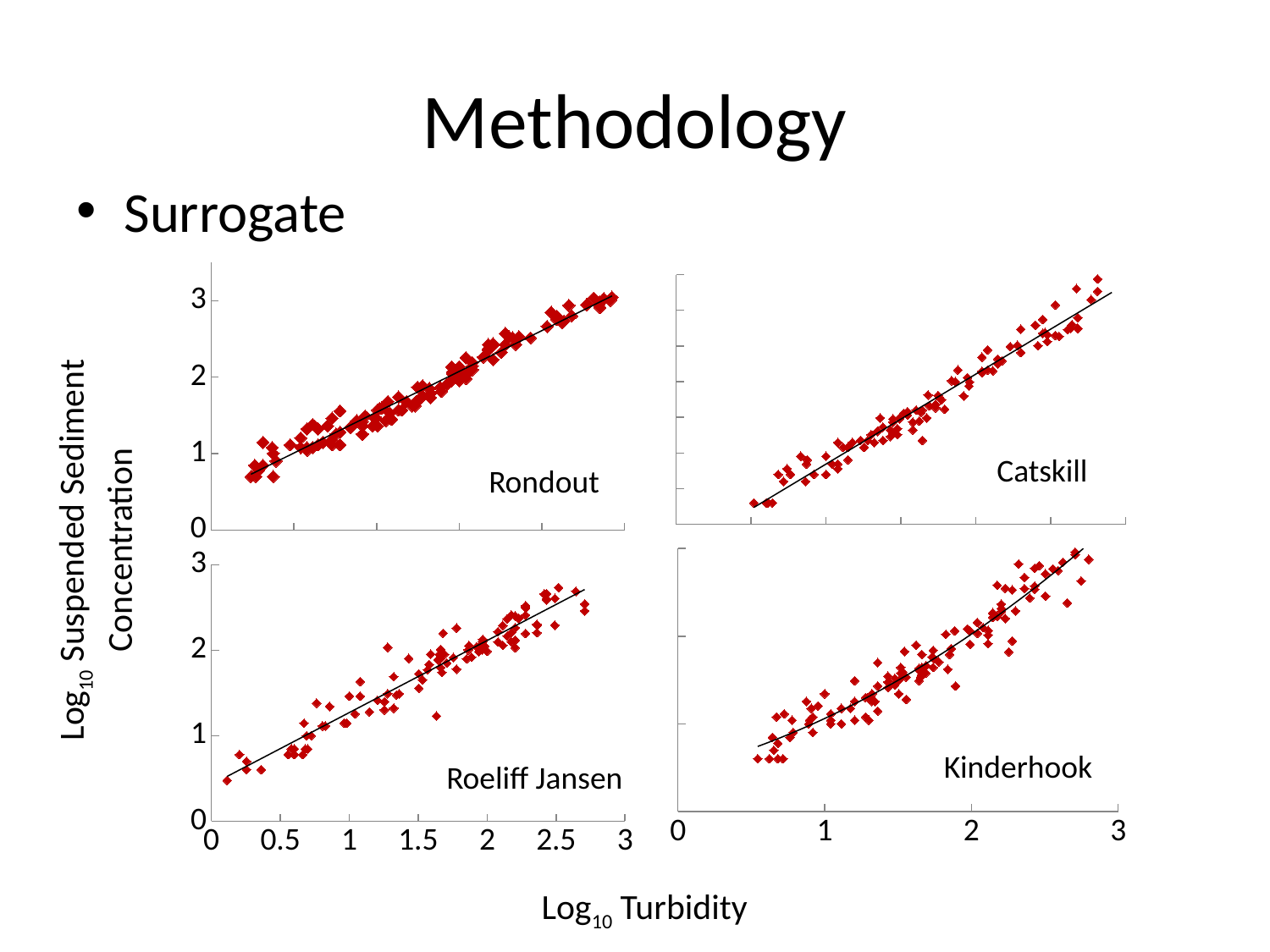
Which chart is in the bottom-right position on the slide? Kinderhook What is the label of the shared y axis for the four charts? Log10 Suspended Sediment Concentration What kind of chart is the Rondout chart? scatter plot Which chart reaches a higher maximum Log10 Suspended Sediment Concentration, Rondout or Roeliff Jansen? Rondout What is the label of the shared x axis for the four charts? Log10 Turbidity In the Rondout chart, is the highest plotted Log10 Suspended Sediment Concentration greater or less than 2? greater In the Rondout chart, do the values rise or fall as Log10 Turbidity increases? rise In the Roeliff Jansen chart, is the lowest plotted Log10 Suspended Sediment Concentration greater or less than 1? less In the Kinderhook chart, do the values rise or fall along the x axis? rise How many charts are shown on the slide? 4 In the Roeliff Jansen chart, is the highest plotted Log10 Suspended Sediment Concentration greater or less than 3? less